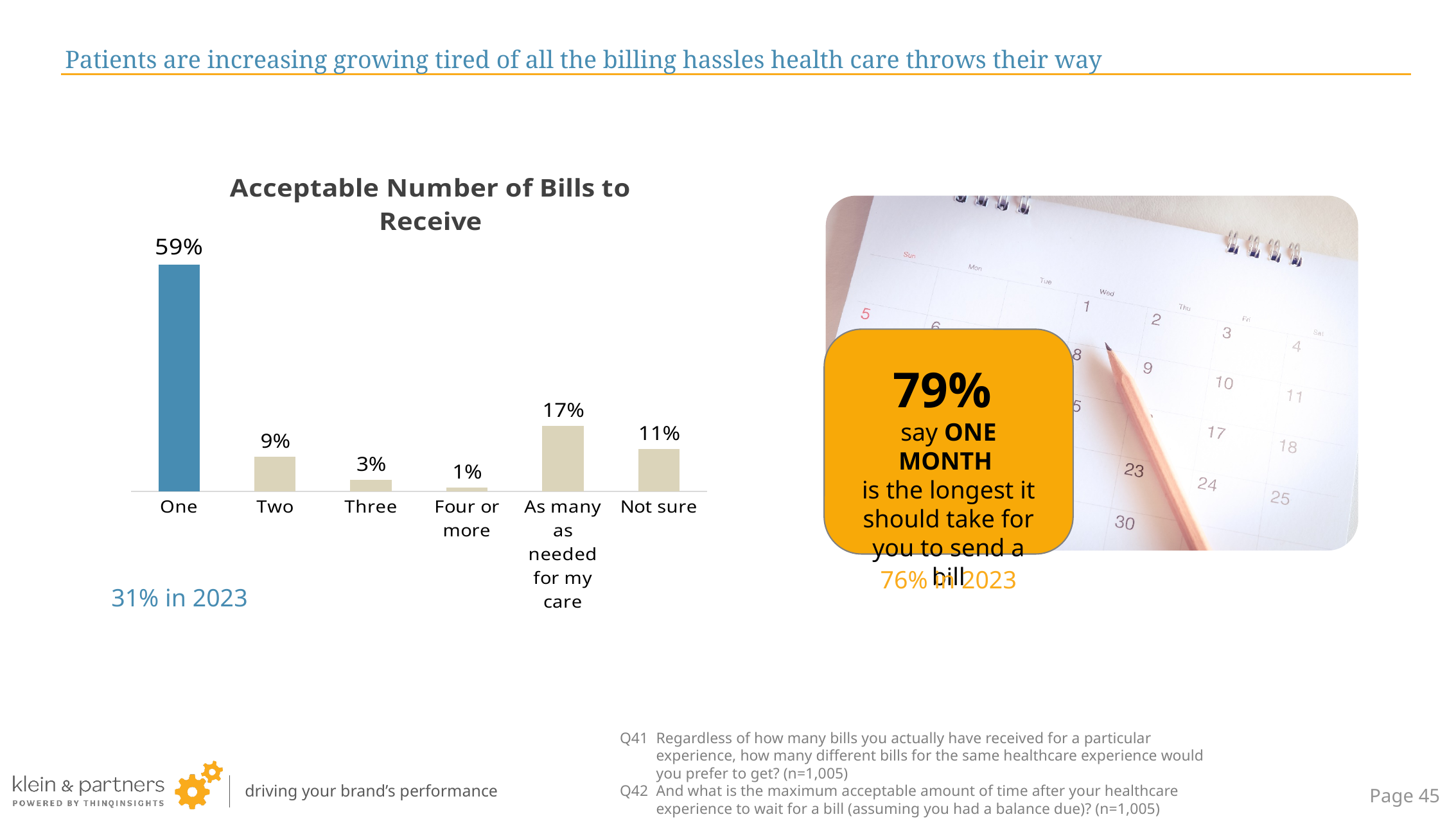
What is the value for "Three" in the Acceptable Number of Bills to Receive chart? 3% How many categories are shown in the Acceptable Number of Bills to Receive chart? 6 What is the difference between the values for "One" and "Two" in the Acceptable Number of Bills to Receive chart? 50% What is the value for "As many as needed for my care" in the Acceptable Number of Bills to Receive chart? 17% Which bar in the Acceptable Number of Bills to Receive chart is coloured blue rather than beige? One What is the value for "One" in the Acceptable Number of Bills to Receive chart? 59% What kind of chart is the Acceptable Number of Bills to Receive chart? Bar chart Which category has the lowest value in the Acceptable Number of Bills to Receive chart? Four or more Which category has the highest value in the Acceptable Number of Bills to Receive chart? One What is the title of the chart on the slide? Acceptable Number of Bills to Receive Which is larger in the Acceptable Number of Bills to Receive chart: "As many as needed for my care" or "Not sure"? As many as needed for my care What is the value for "Not sure" in the Acceptable Number of Bills to Receive chart? 11%